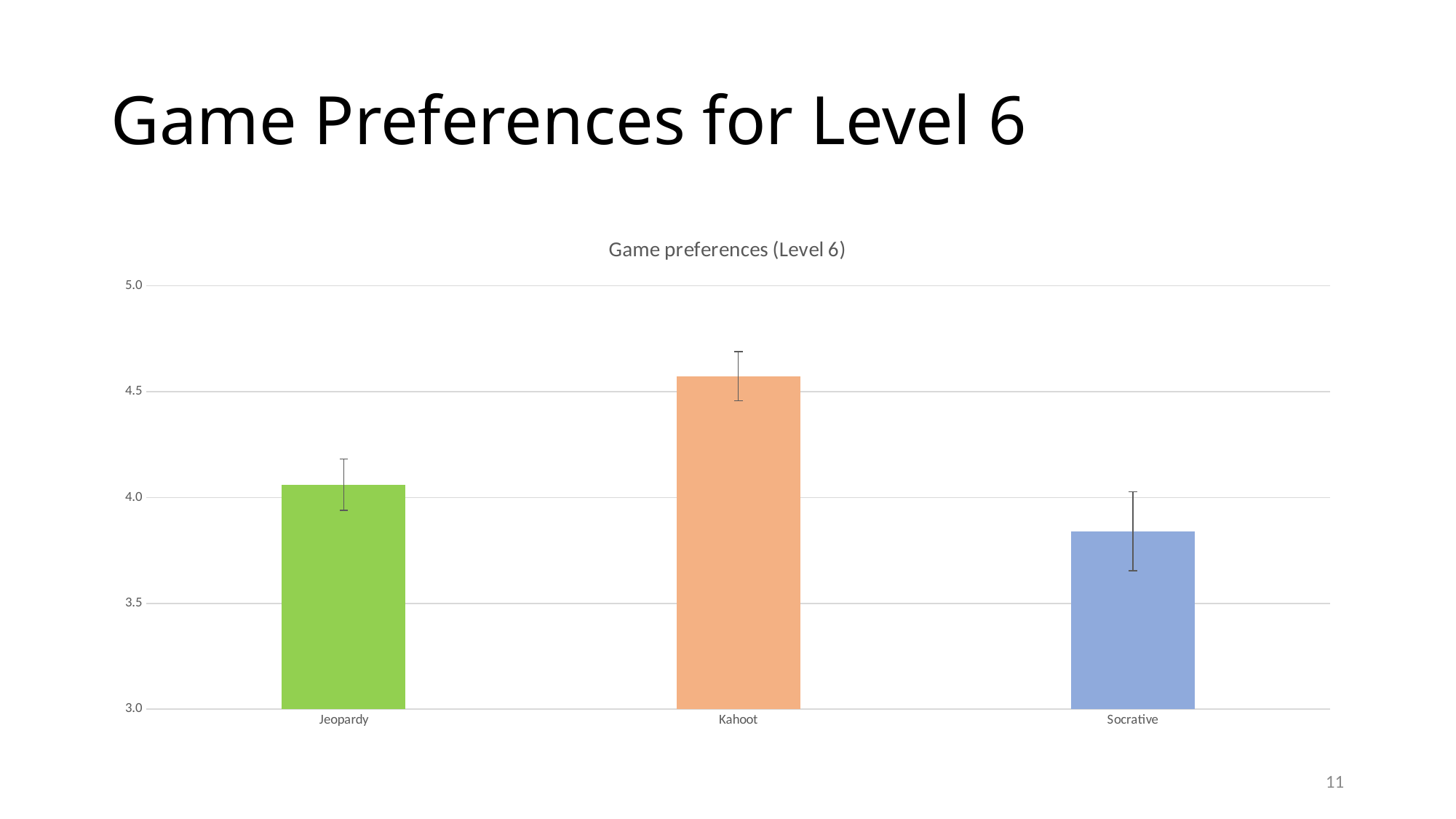
Which is larger, the value for Kahoot or the value for Jeopardy? Kahoot Which game has the lowest value? Socrative What is the lowest value shown on the vertical axis? 3.0 Is the value for Kahoot greater or less than 4.5? greater Which is larger, the value for Jeopardy or the value for Socrative? Jeopardy Is the value for Jeopardy greater or less than 4.0? greater What kind of chart is shown on the slide? bar chart How many games are shown on the chart? 3 What colour is the bar for Kahoot? orange Is the value for Socrative greater or less than 4.0? less Which game has the highest value? Kahoot What is the title of the chart? Game preferences (Level 6)